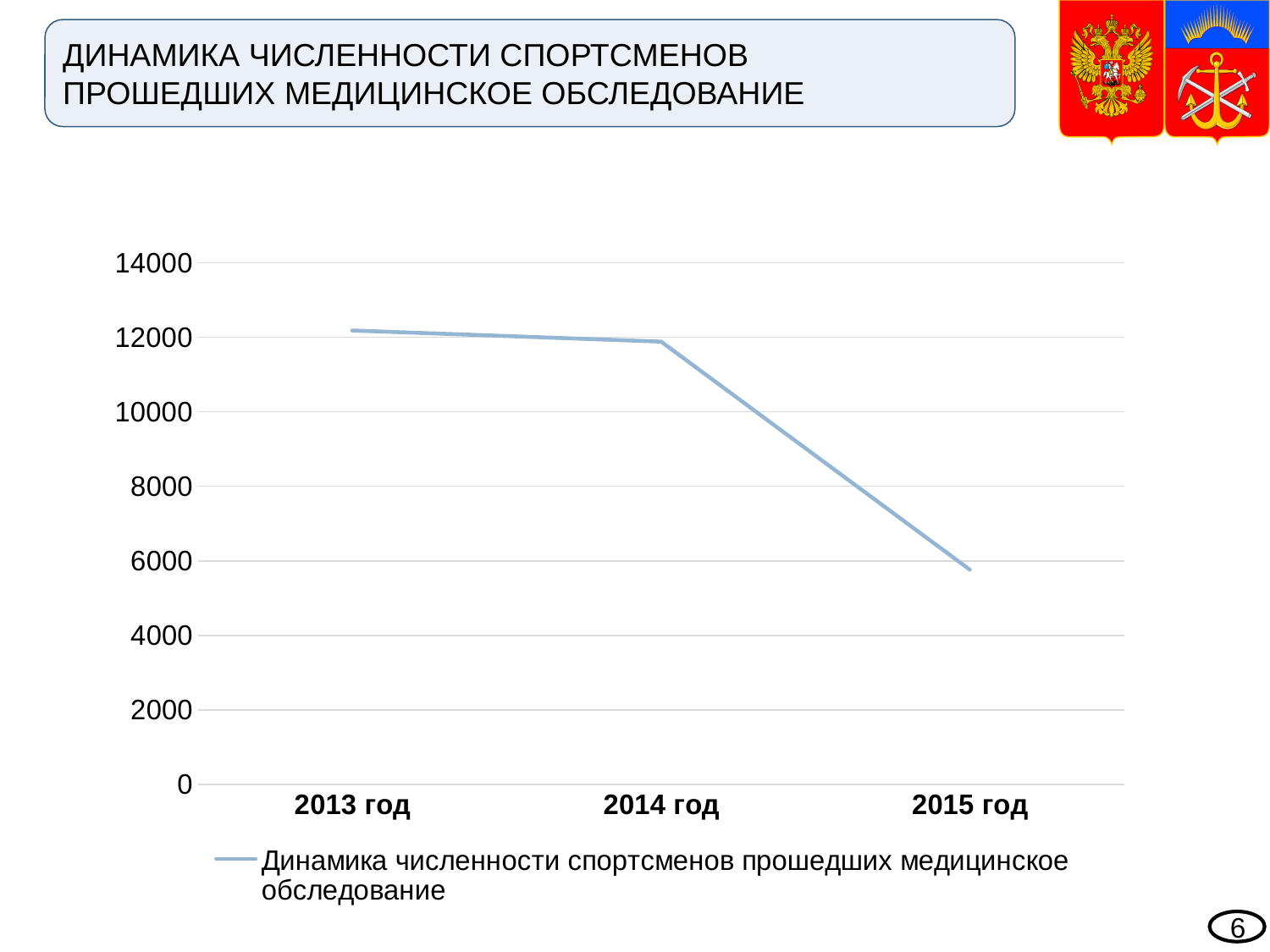
Which is larger, the value for 2013 год or the value for 2015 год? 2013 год How many years are plotted on the x axis of the chart? 3 What is the legend entry for the series plotted on the chart? Динамика численности спортсменов прошедших медицинское обследование Is the value for 2013 год greater or less than 10000? greater How many series does the chart's legend list? 1 Which year has the lowest value on the chart? 2015 год Do the values rise or fall from 2013 год to 2015 год? fall Is the value for 2014 год greater or less than 10000? greater What kind of chart is shown on the slide? line chart What is the highest value shown on the chart's vertical axis? 14000 Is the value for 2015 год greater or less than 8000? less Which is larger, the value for 2014 год or the value for 2015 год? 2014 год